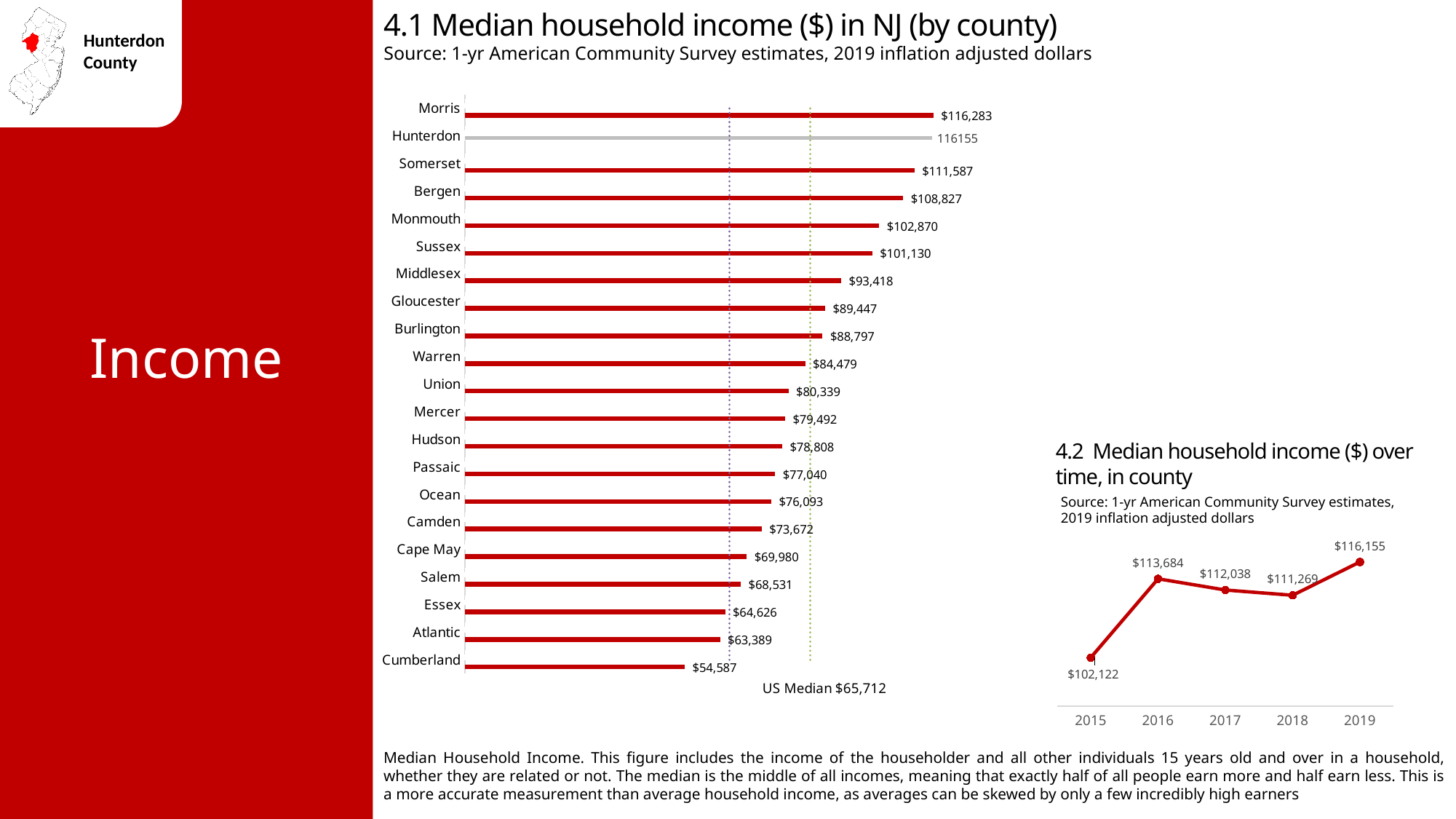
In chart 4.1, what is the median household income for Somerset county? $111,587 In chart 4.1, which county has a higher median household income, Bergen or Monmouth? Bergen In chart 4.1, how many counties are shown? 21 In chart 4.1, which county has the lowest median household income? Cumberland In chart 4.1, which county has the highest median household income? Morris In chart 4.2, what is the difference between the median household income in 2019 and in 2015? $14,033 What kind of chart is chart 4.2? Line chart In chart 4.1, what is the difference between the median household income of Morris and Cumberland counties? $61,696 In chart 4.1, what is the median household income for Cumberland county? $54,587 In chart 4.2, what was the median household income in 2015? $102,122 In chart 4.2, which year has the lowest median household income? 2015 In chart 4.1, what US Median value is noted on the chart? $65,712